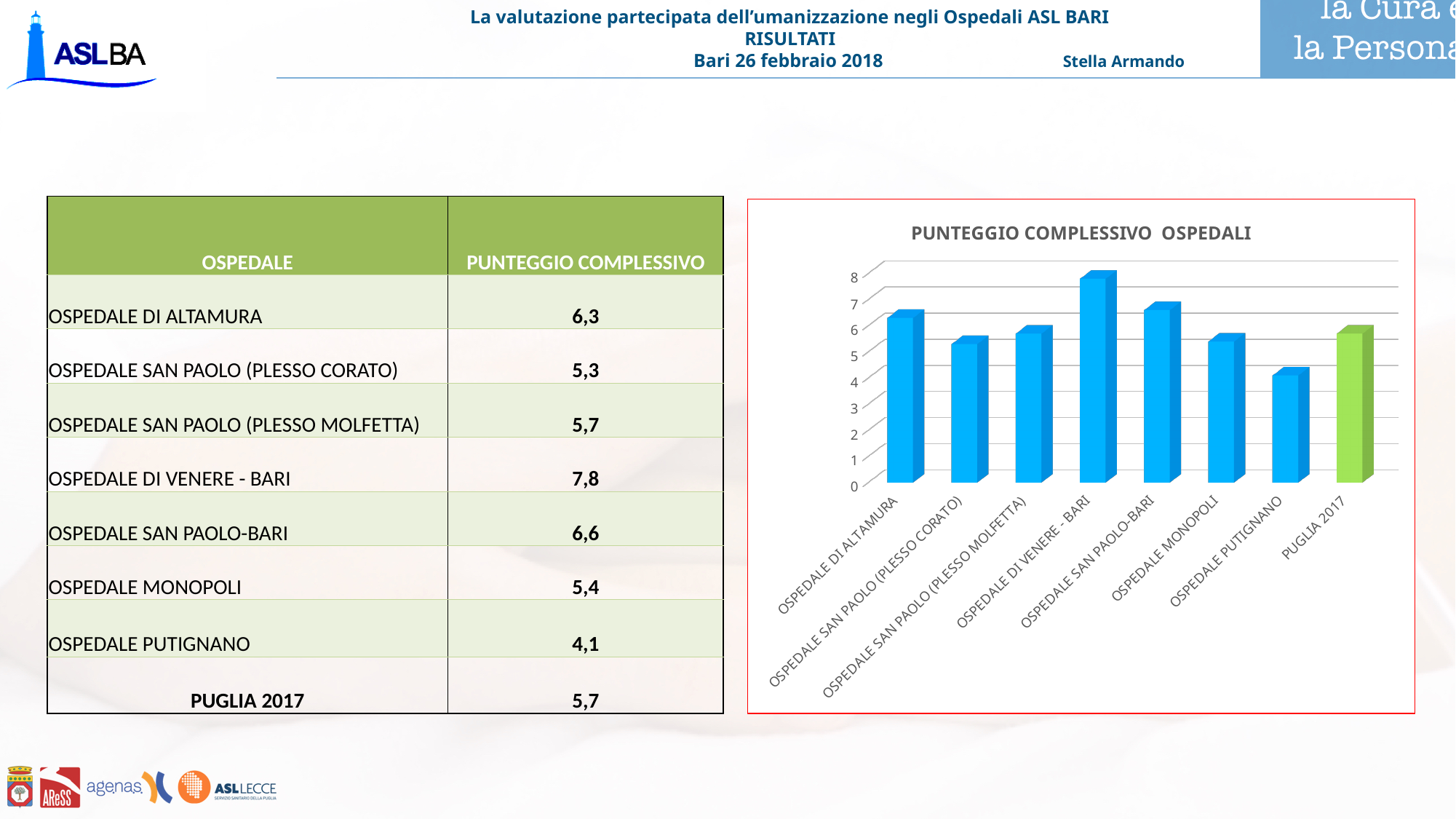
Is the value for OSPEDALE DI VENERE - BARI greater or less than 7? greater Which is larger, the value for OSPEDALE DI ALTAMURA or the value for OSPEDALE MONOPOLI? OSPEDALE DI ALTAMURA Which category has the highest bar in the chart? OSPEDALE DI VENERE - BARI What is the difference between the value for OSPEDALE DI VENERE - BARI and the value for OSPEDALE PUTIGNANO? 3,7 What is the title of the chart? PUNTEGGIO COMPLESSIVO OSPEDALI Is the value for OSPEDALE PUTIGNANO greater or less than 5? less Which category has the lowest bar in the chart? OSPEDALE PUTIGNANO What is the value for OSPEDALE DI VENERE - BARI? 7,8 How many bars does the chart have? 8 What kind of chart is shown on the slide? bar chart What is the value for OSPEDALE PUTIGNANO? 4,1 What is the value for PUGLIA 2017? 5,7